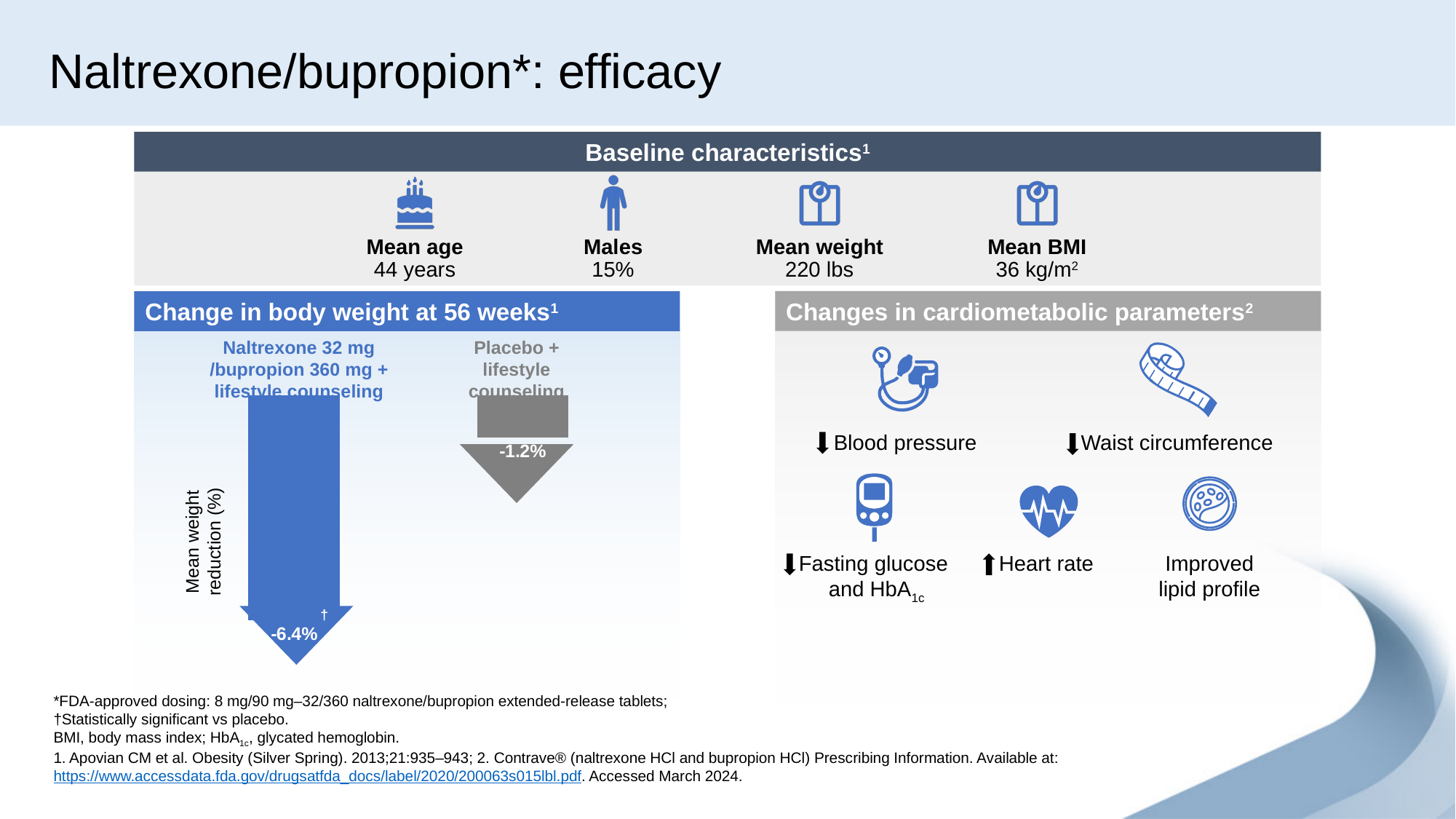
In the 'Change in body weight at 56 weeks' chart, is the mean weight reduction for the naltrexone/bupropion group greater or less than 5%? greater What is the y-axis label of the 'Change in body weight at 56 weeks' chart? Mean weight reduction (%) In the 'Change in body weight at 56 weeks' chart, which group's result is marked with a dagger (†) indicating statistical significance vs placebo? Naltrexone 32 mg/bupropion 360 mg + lifestyle counseling In the 'Change in body weight at 56 weeks' chart, is the weight reduction for naltrexone/bupropion larger or smaller than for placebo? Larger In the 'Change in body weight at 56 weeks' chart, what is the difference in mean weight reduction between the naltrexone/bupropion group and the placebo group? 5.2 percentage points In the 'Change in body weight at 56 weeks' chart, is the mean weight reduction for the placebo group greater or less than 2%? less In the 'Change in body weight at 56 weeks' chart, what is the mean weight reduction for placebo + lifestyle counseling? -1.2% How many treatment groups are shown in the 'Change in body weight at 56 weeks' chart? 2 In the 'Change in body weight at 56 weeks' chart, what is the mean weight reduction for naltrexone 32 mg/bupropion 360 mg + lifestyle counseling? -6.4% In the 'Change in body weight at 56 weeks' chart, which group shows the larger mean weight reduction? Naltrexone 32 mg/bupropion 360 mg + lifestyle counseling In the 'Change in body weight at 56 weeks' chart, which group shows the smaller mean weight reduction? Placebo + lifestyle counseling